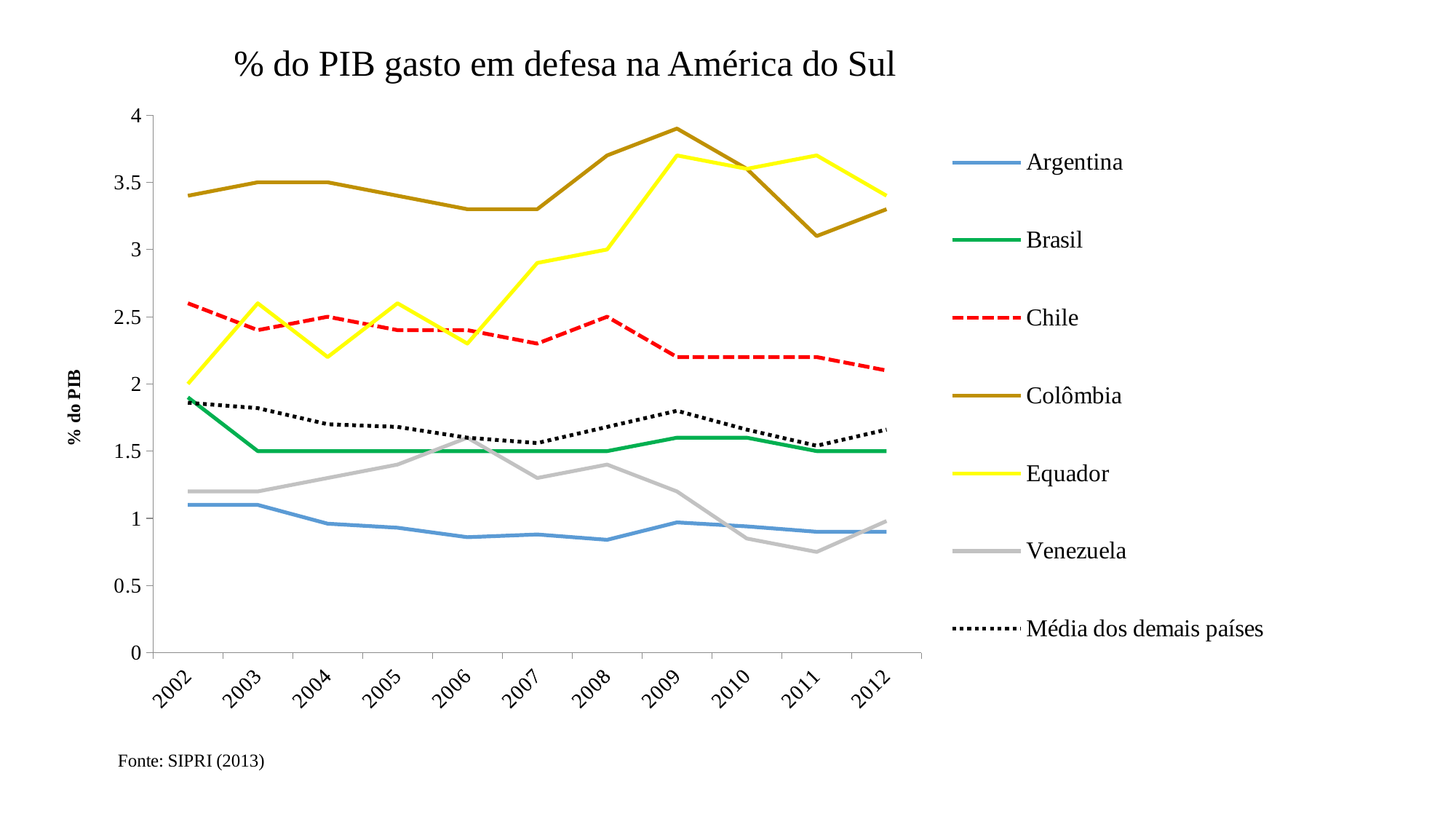
Is the value for Chile in 2012 greater or less than 2? greater What kind of chart is shown on the slide? line chart Which country has the lowest value in 2011? Venezuela Does the value for Chile rise or fall overall from 2002 to 2012? fall What is the title of the chart? % do PIB gasto em defesa na América do Sul How many series does the legend list? 7 Which is larger in 2005, the value for Chile or the value for Brasil? Chile How many years are shown on the x axis? 11 Which country has the highest value in 2009? Colômbia Is the value for Argentina in 2008 greater or less than 1? less Is the value for Colômbia in 2009 greater or less than 3.5? greater Which country has the highest value in 2011? Equador